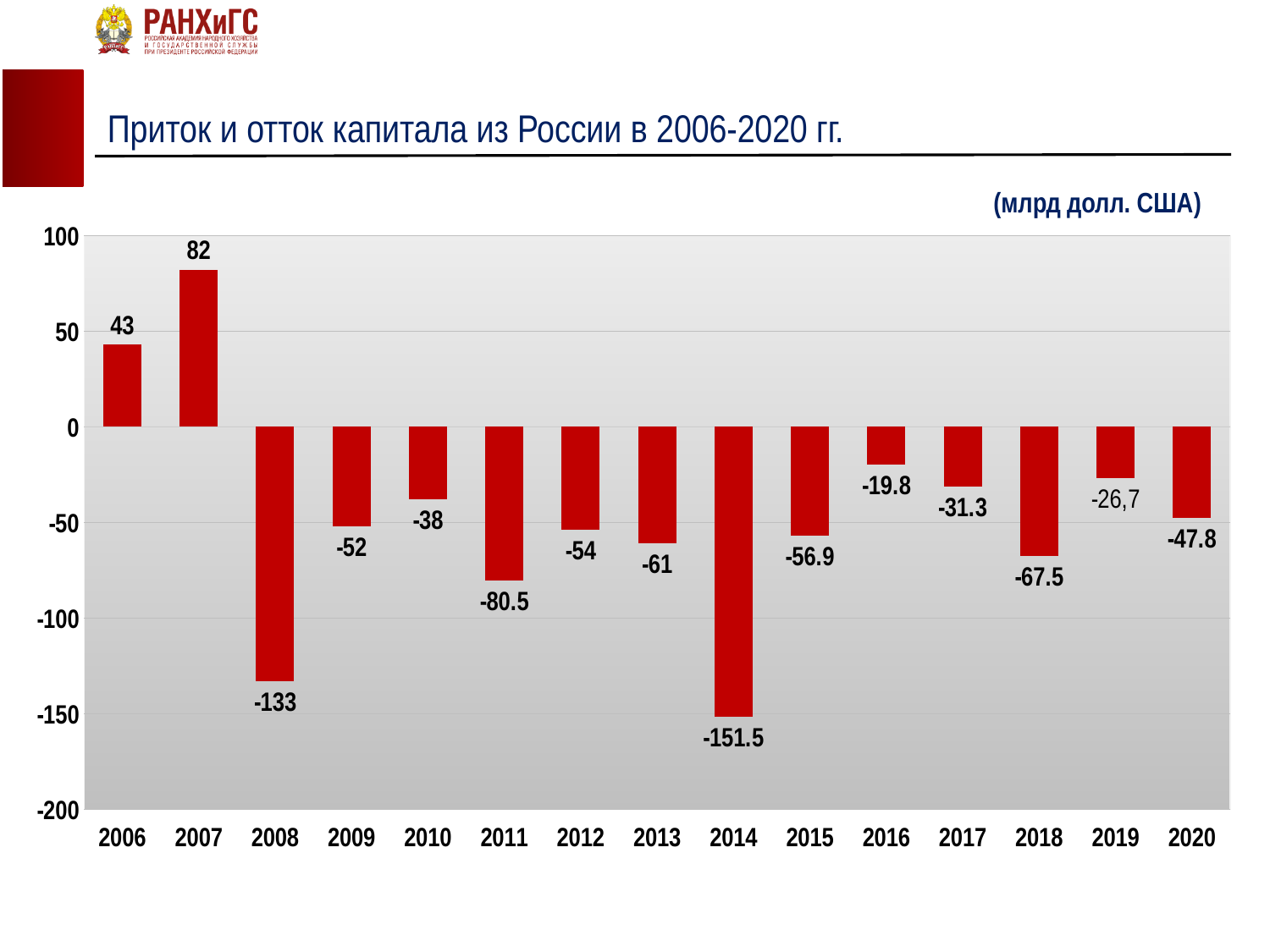
What is the value for 2014? -151.5 Which is larger, the value for 2010 or the value for 2011? 2010 What is the value for 2016? -19.8 Which year has the lowest value? 2014 What is the difference between the values for 2008 and 2014? 18.5 What is the difference between the values for 2007 and 2006? 39 Which year has the highest value? 2007 What unit is stated for the values on the chart? млрд долл. США What kind of chart is shown on the slide? bar chart What is the value for 2019? -26,7 What is the value for 2007? 82 How many years are shown on the x axis? 15